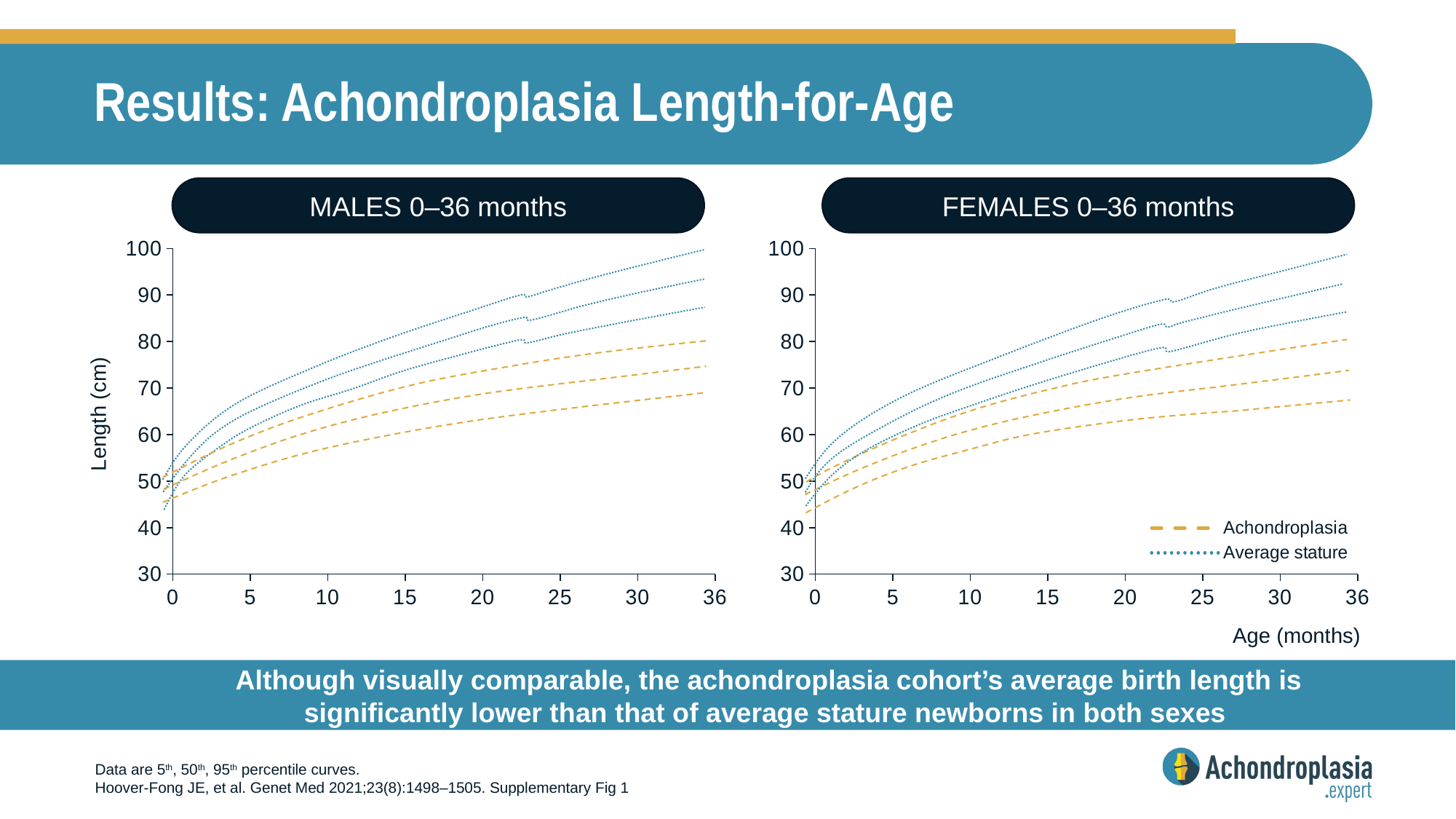
How many curves are plotted in the FEMALES 0–36 months chart? 6 What is the label of the y axis on the MALES 0–36 months chart? Length (cm) In the FEMALES 0–36 months chart, is the value of the lowest Achondroplasia curve at 36 months greater or less than 70? less In the MALES 0–36 months chart, do the Achondroplasia curves rise or fall as age increases? Rise In the MALES 0–36 months chart, is the value of the highest Average stature curve at 36 months greater or less than 90? greater What kind of chart is the MALES 0–36 months chart? Line chart In the MALES 0–36 months chart, is the value of the lowest Achondroplasia curve at 36 months greater or less than 80? less In the MALES 0–36 months chart, at 36 months, which is higher: the highest Average stature curve or the highest Achondroplasia curve? Average stature In the FEMALES 0–36 months chart, which line style represents Achondroplasia in the legend? Dashed line In the FEMALES 0–36 months chart, do the Average stature curves rise or fall as age increases? Rise How many series does the legend on the FEMALES 0–36 months chart list? 2